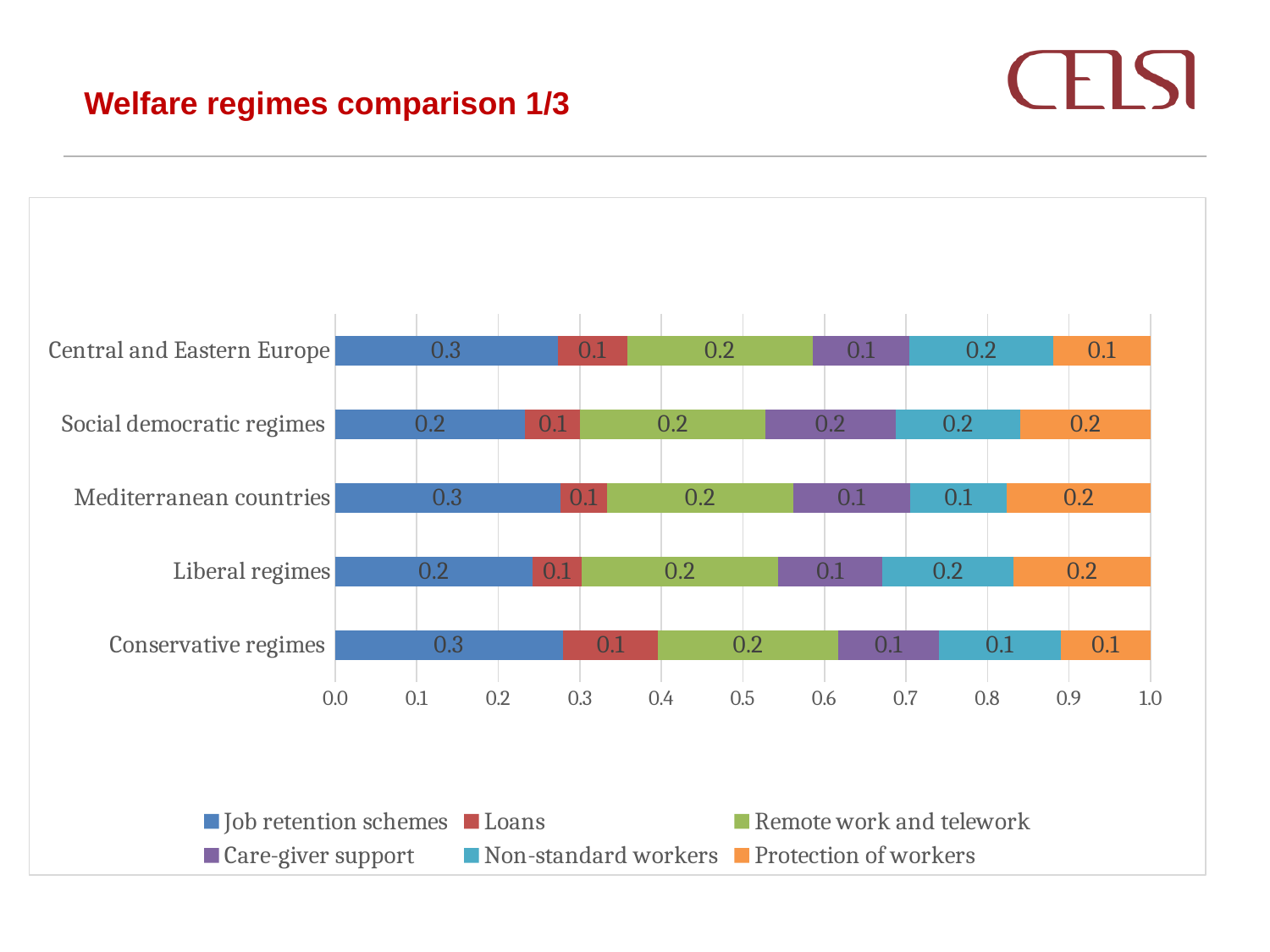
What is the value of Loans for Conservative regimes? 0.1 What is the title of the slide containing the chart? Welfare regimes comparison 1/3 What is the value of Job retention schemes for Central and Eastern Europe? 0.3 What is the value of Care-giver support for Liberal regimes? 0.1 Which series is shown in orange in the legend? Protection of workers How many welfare regime categories are plotted on the chart? 5 What is the value of Protection of workers for Social democratic regimes? 0.2 What is the value of Remote work and telework for Social democratic regimes? 0.2 Is the Job retention schemes value for Conservative regimes greater or less than 0.2? greater What kind of chart is shown on the slide? Stacked bar chart What is the value of Non-standard workers for Mediterranean countries? 0.1 How many series does the legend list? 6